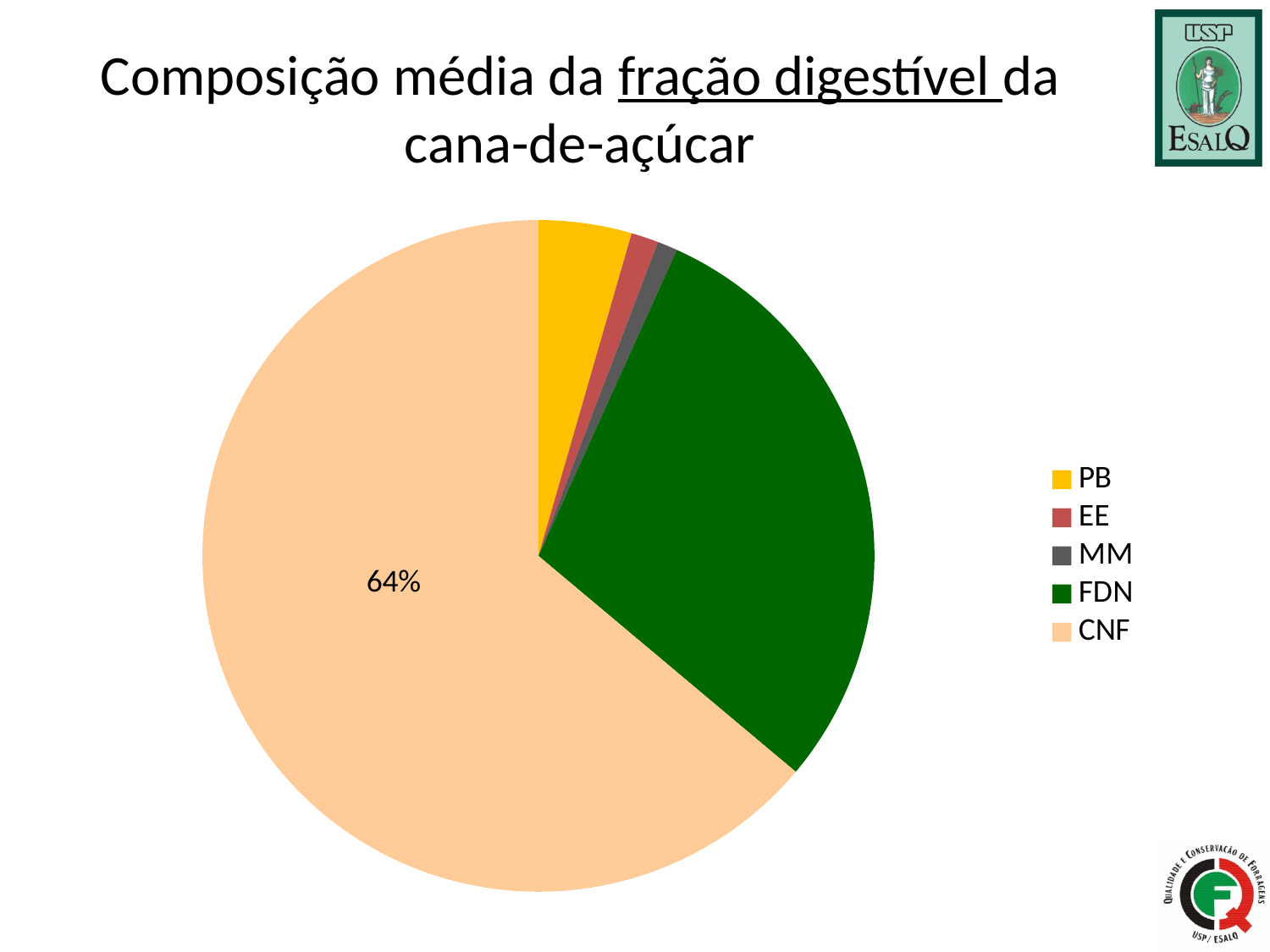
How many entries does the legend list? 5 What colour is the FDN slice? Dark green Which category is the second largest slice of the pie? FDN Which category has the largest slice of the pie? CNF What is the title of the chart on the slide? Composição média da fração digestível da cana-de-açúcar What share of the pie does CNF represent? 64% Which slice is larger, FDN or PB? FDN Is the share for CNF greater or less than 50%? greater What kind of chart is shown on the slide? Pie chart How many categories are shown in the pie chart? 5 Which slice is larger, CNF or FDN? CNF